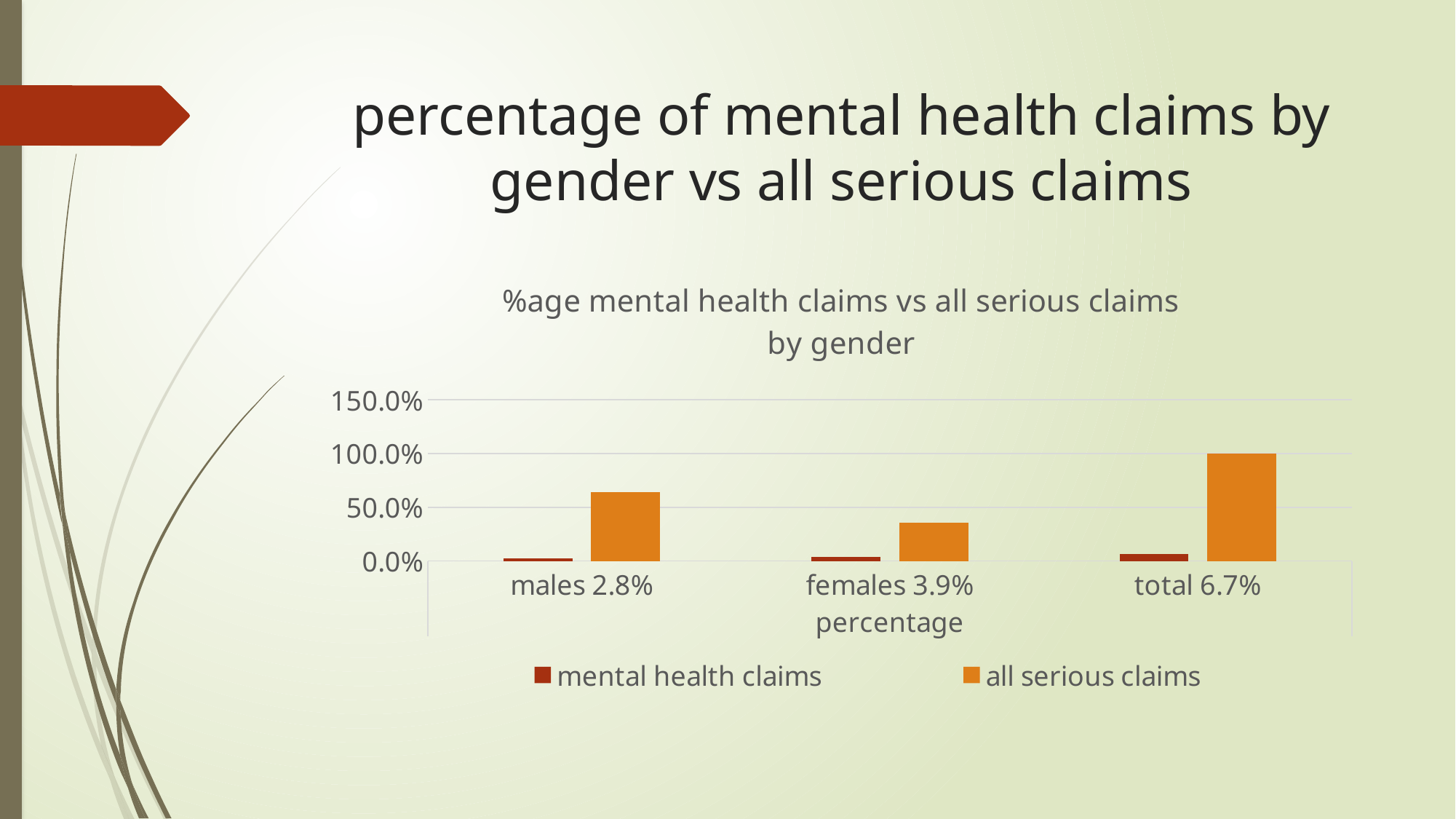
Which is larger for all serious claims: males or females? males Which category has the lowest value for all serious claims? females 3.9% How many categories are shown on the x axis? 3 What is the value of all serious claims for the total category? 100.0% Which is larger for males: mental health claims or all serious claims? all serious claims Is the value of all serious claims for males greater or less than 50.0%? greater What kind of chart is shown on the slide? bar chart What is the title of the chart? %age mental health claims vs all serious claims by gender How many series does the legend list? 2 Which category has the highest value for all serious claims? total 6.7% Which series is shown in orange? all serious claims Is the value of all serious claims for females greater or less than 50.0%? less